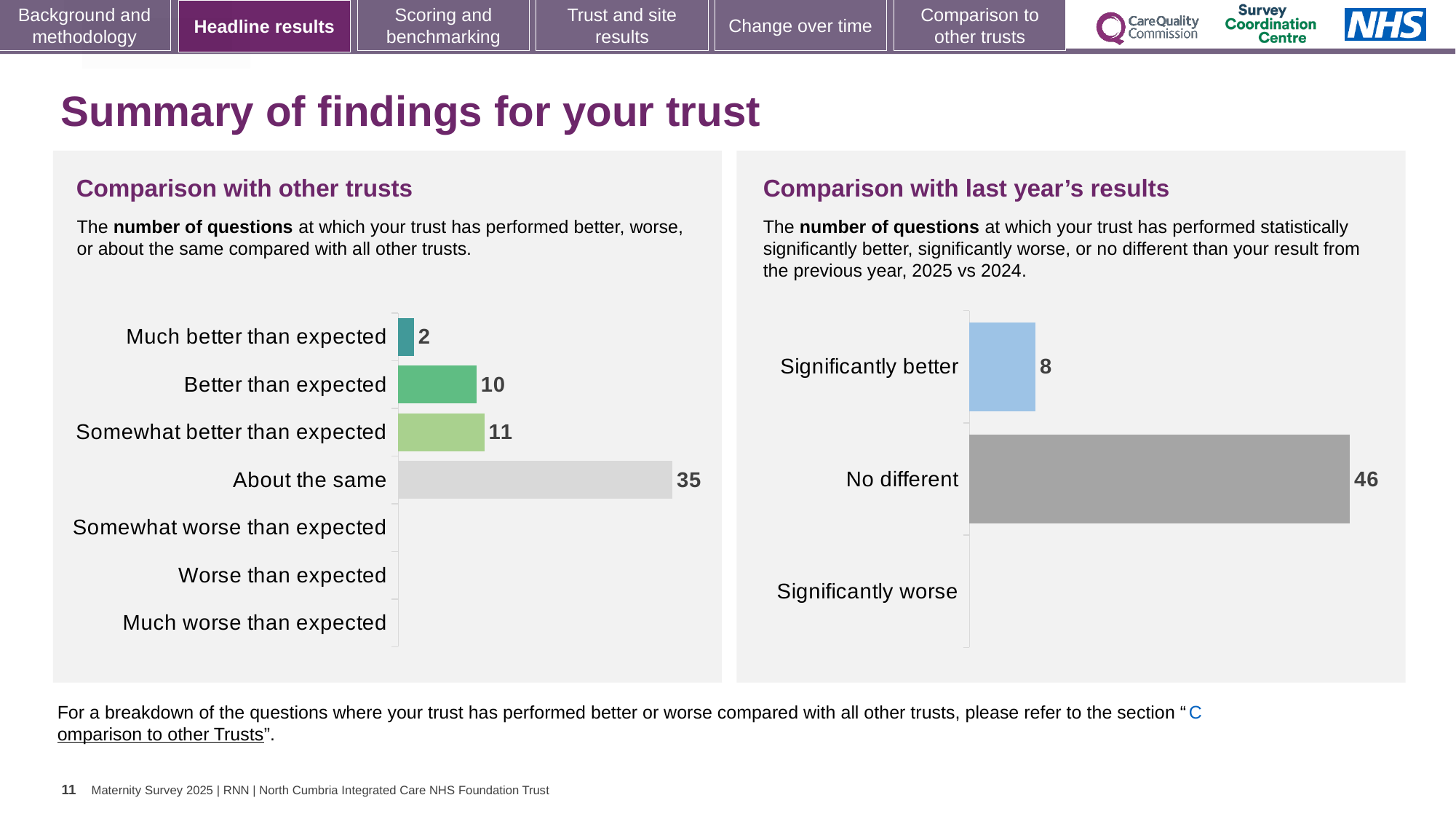
In the 'Comparison with other trusts' chart, what is the value for 'Much better than expected'? 2 In the 'Comparison with last year's results' chart, what is the value for 'Significantly better'? 8 In the 'Comparison with other trusts' chart, which category has the highest value? About the same In the 'Comparison with other trusts' chart, which is larger: 'Better than expected' or 'Much better than expected'? Better than expected In the 'Comparison with other trusts' chart, what is the value for 'About the same'? 35 In the 'Comparison with other trusts' chart, what is the difference between 'Somewhat better than expected' and 'Better than expected'? 1 In the 'Comparison with last year's results' chart, how many categories are listed on the axis? 3 In the 'Comparison with other trusts' chart, what is the value for 'Somewhat better than expected'? 11 In the 'Comparison with last year's results' chart, what is the value for 'No different'? 46 In the 'Comparison with last year's results' chart, what is the difference between 'No different' and 'Significantly better'? 38 In the 'Comparison with other trusts' chart, how many categories are listed on the axis? 7 What type of chart is the 'Comparison with last year's results' chart? Bar chart